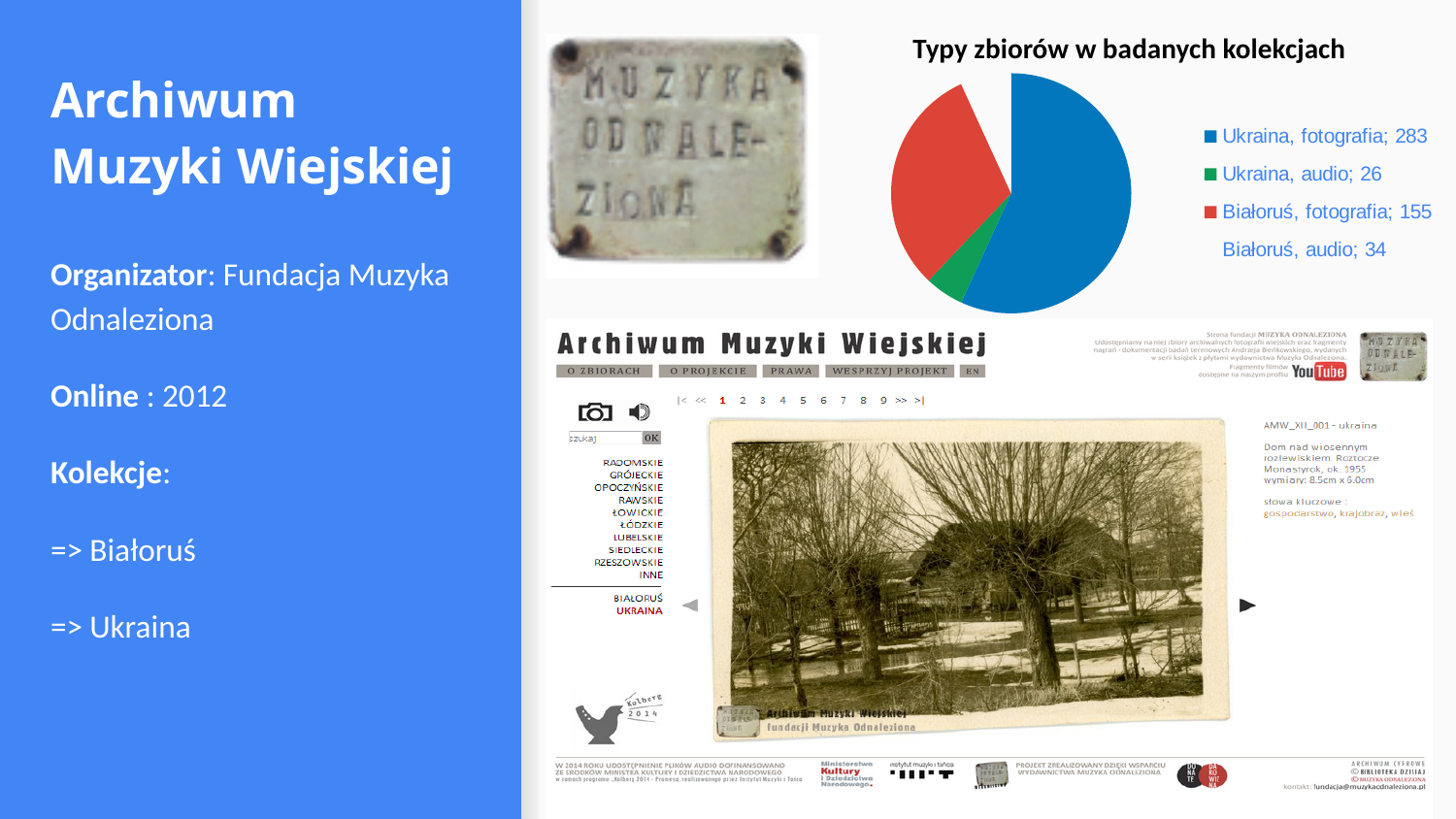
Which is larger: the value for "Białoruś, audio" or the value for "Ukraina, audio"? Białoruś, audio How many categories does the pie chart legend list? 4 Which category has the lowest value in the pie chart? Ukraina, audio What is the difference between the values for "Ukraina, fotografia" and "Białoruś, fotografia"? 128 What is the value for "Białoruś, audio" in the pie chart? 34 What kind of chart is shown on the slide? pie chart What is the value for "Ukraina, fotografia" in the pie chart? 283 What is the value for "Białoruś, fotografia" in the pie chart? 155 What is the difference between the values for "Białoruś, audio" and "Ukraina, audio"? 8 What is the value for "Ukraina, audio" in the pie chart? 26 What is the title of the pie chart? Typy zbiorów w badanych kolekcjach Which category has the highest value in the pie chart? Ukraina, fotografia